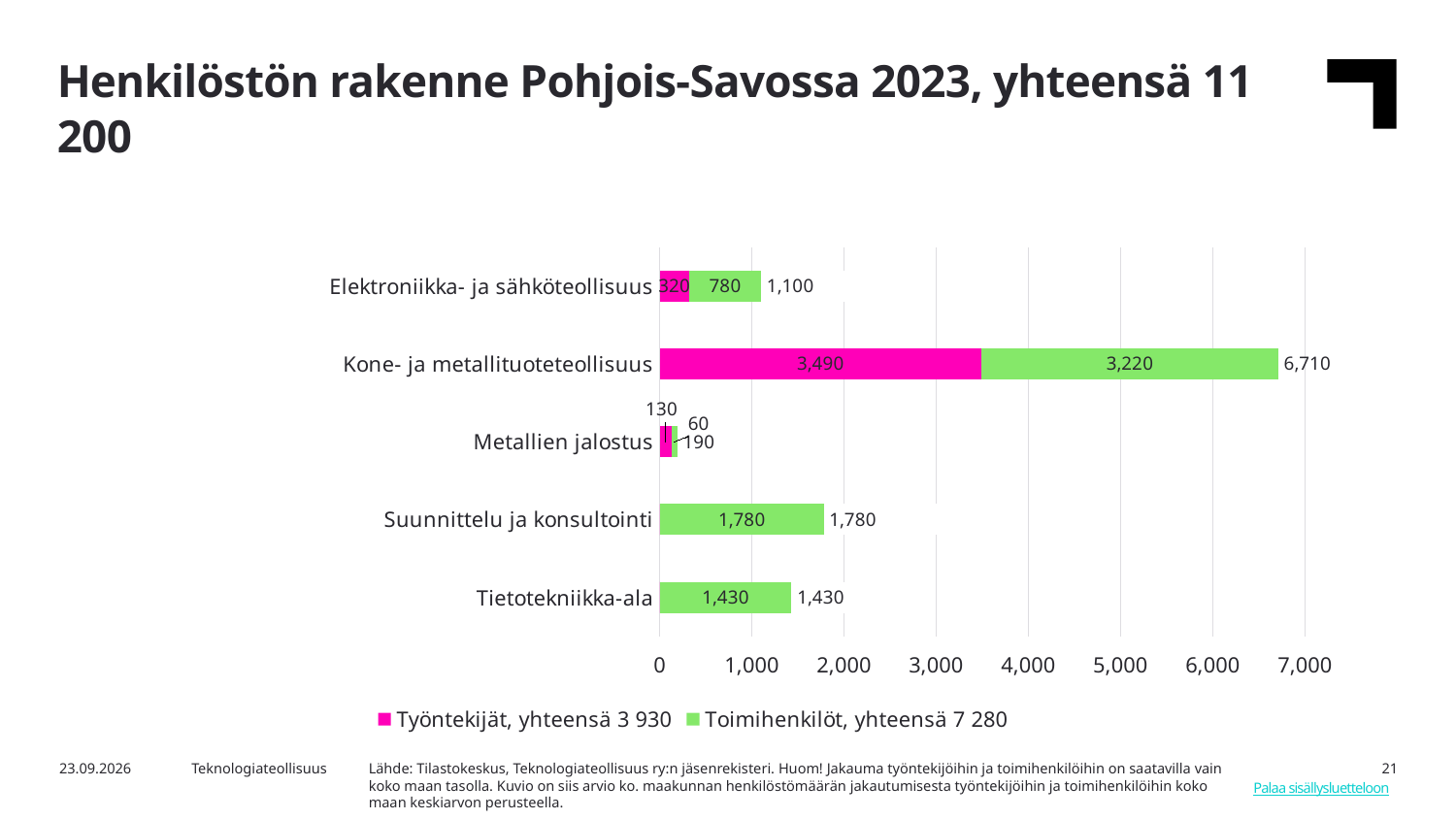
What is the total for the Kone- ja metallituoteteollisuus bar? 6,710 Which is larger: the total for Suunnittelu ja konsultointi or the total for Tietotekniikka-ala? Suunnittelu ja konsultointi Which category has the highest total? Kone- ja metallituoteteollisuus What type of chart is shown on the slide? Stacked bar chart What is the total for the Metallien jalostus bar? 190 What is the Työntekijät value for Kone- ja metallituoteteollisuus? 3,490 What is the Toimihenkilöt value for Suunnittelu ja konsultointi? 1,780 How many categories are shown on the chart? 5 What is the difference between the Työntekijät and Toimihenkilöt values for Kone- ja metallituoteteollisuus? 270 Which category has the lowest total? Metallien jalostus How many series does the legend list? 2 What is the Toimihenkilöt value for Elektroniikka- ja sähköteollisuus? 780